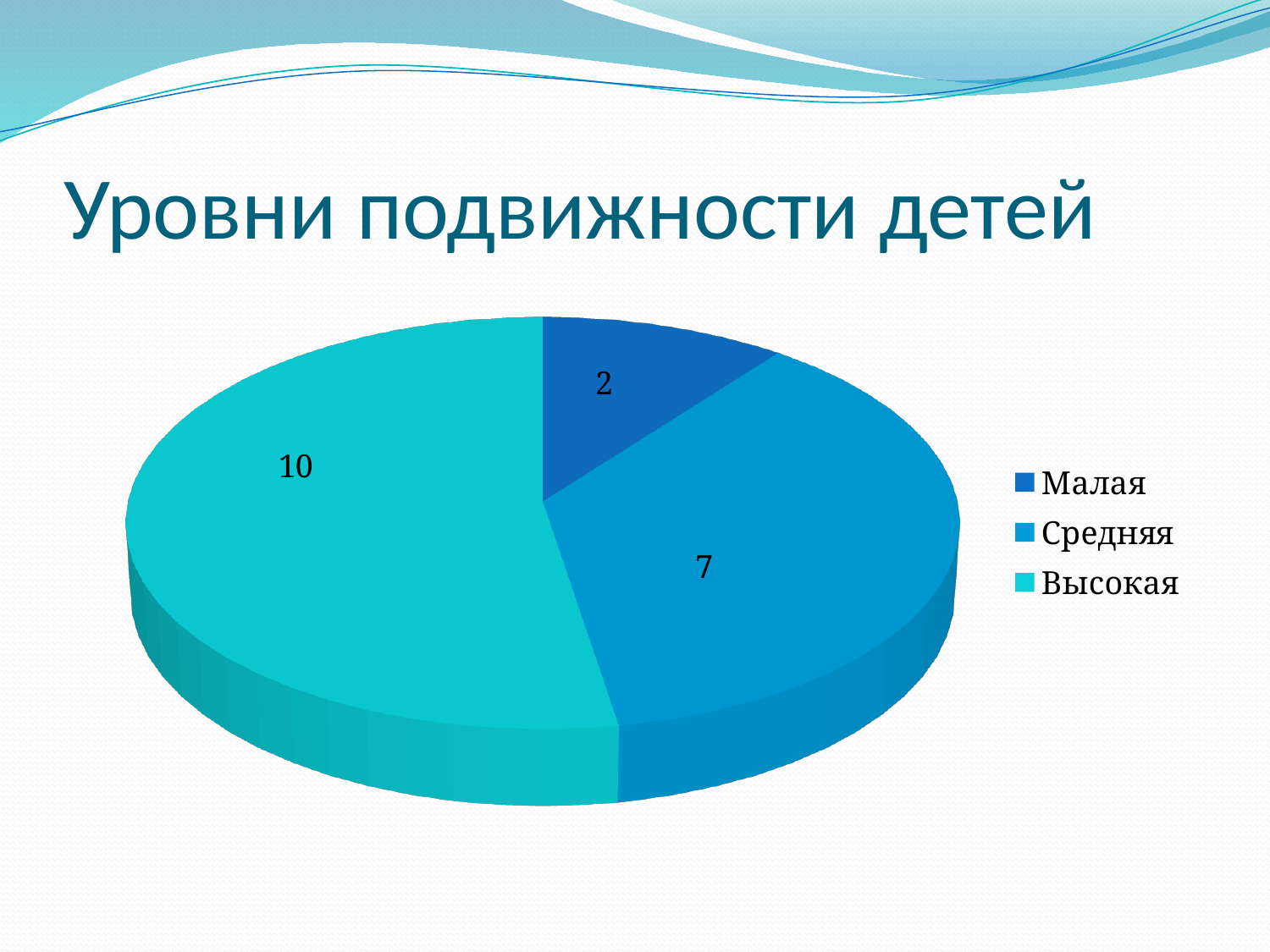
What is the difference between the values for Средняя and Малая? 5 Which category has the smallest slice? Малая What is the difference between the values for Высокая and Средняя? 3 What is the total of all slices in the pie chart? 19 What is the title of the slide? Уровни подвижности детей Which category has the largest slice? Высокая What is the value for Малая? 2 What type of chart is shown on the slide? pie chart What is the value for Высокая? 10 Which is larger, the value for Средняя or the value for Малая? Средняя How many categories does the pie chart have? 3 What is the value for Средняя? 7